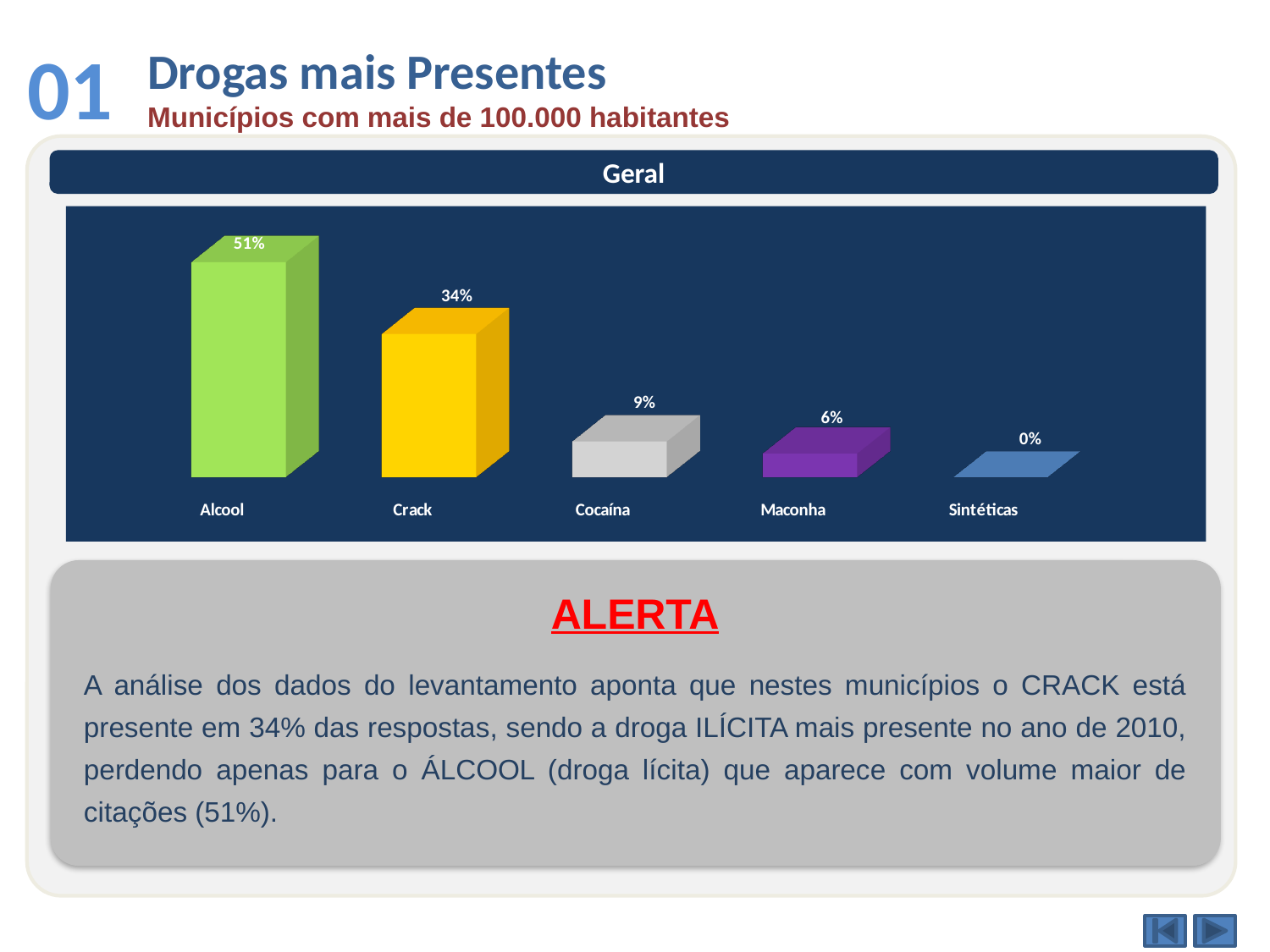
Which category has the lowest value? Sintéticas How many categories are shown in the chart? 5 Which category has the highest value? Alcool What is the value for Cocaína? 9% Which is larger, the value for Cocaína or the value for Maconha? Cocaína What is the value for Sintéticas? 0% What is the title shown above the chart? Geral What is the difference between the values for Alcool and Crack? 17% What is the value for Maconha? 6% What is the value for Crack? 34% What is the value for Alcool? 51% What kind of chart is shown on the slide? Bar chart